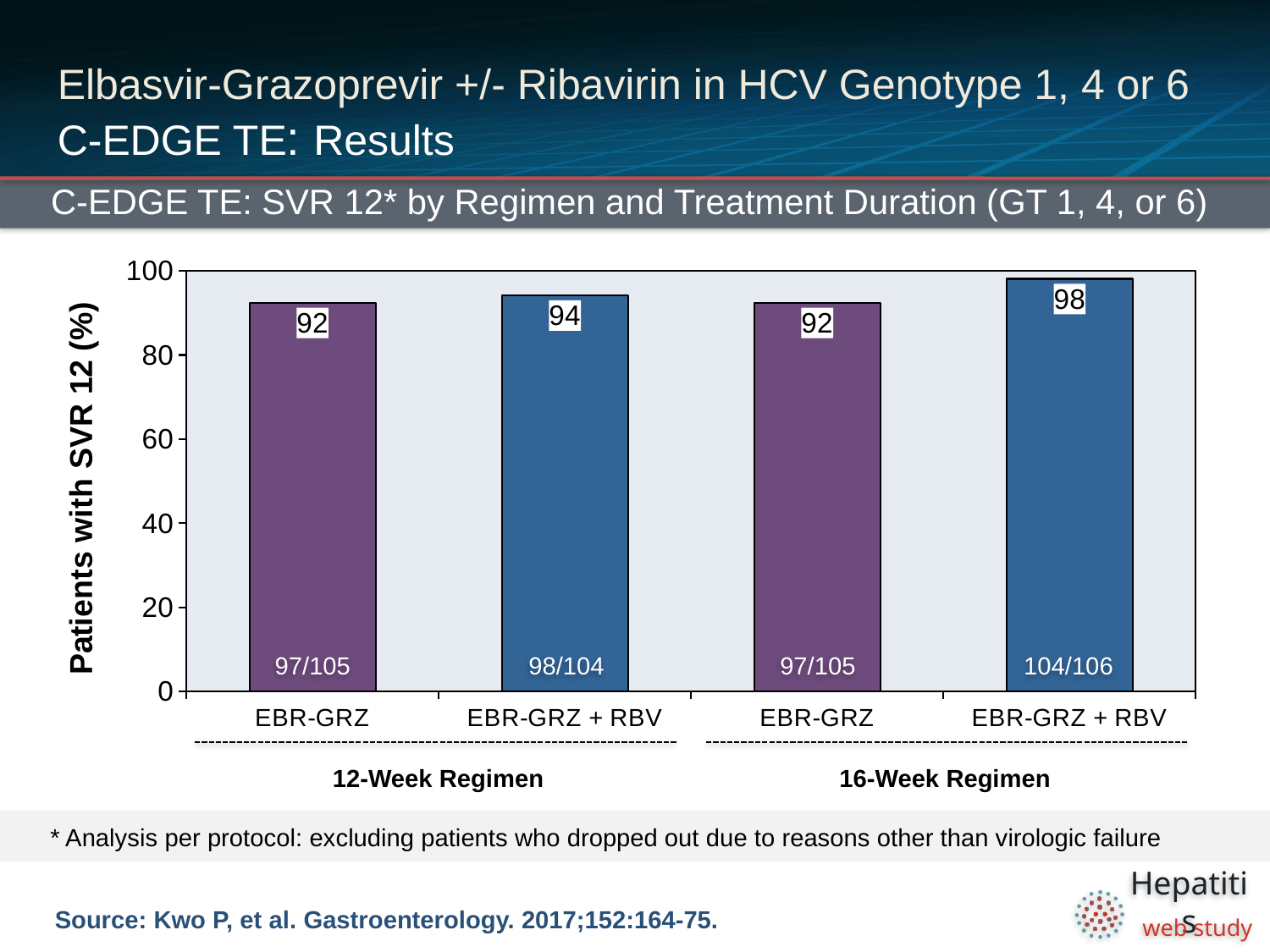
What is the label of the y-axis? Patients with SVR 12 (%) What is the difference in SVR 12 rate between EBR-GRZ + RBV and EBR-GRZ in the 12-Week Regimen? 2 What is the SVR 12 rate for EBR-GRZ + RBV in the 16-Week Regimen? 98 What is the SVR 12 rate for EBR-GRZ + RBV in the 12-Week Regimen? 94 Which has a higher SVR 12 rate: EBR-GRZ + RBV in the 12-Week Regimen or EBR-GRZ + RBV in the 16-Week Regimen? EBR-GRZ + RBV in the 16-Week Regimen What is the difference in SVR 12 rate between EBR-GRZ + RBV and EBR-GRZ in the 16-Week Regimen? 6 Which bar has the highest SVR 12 rate? EBR-GRZ + RBV, 16-Week Regimen How many bars are shown in the chart? 4 What is the SVR 12 rate for EBR-GRZ in the 12-Week Regimen? 92 How many patients achieved SVR 12 out of the total for EBR-GRZ in the 12-Week Regimen? 97/105 What type of chart is shown on the slide? Bar chart How many patients achieved SVR 12 out of the total for EBR-GRZ + RBV in the 16-Week Regimen? 104/106